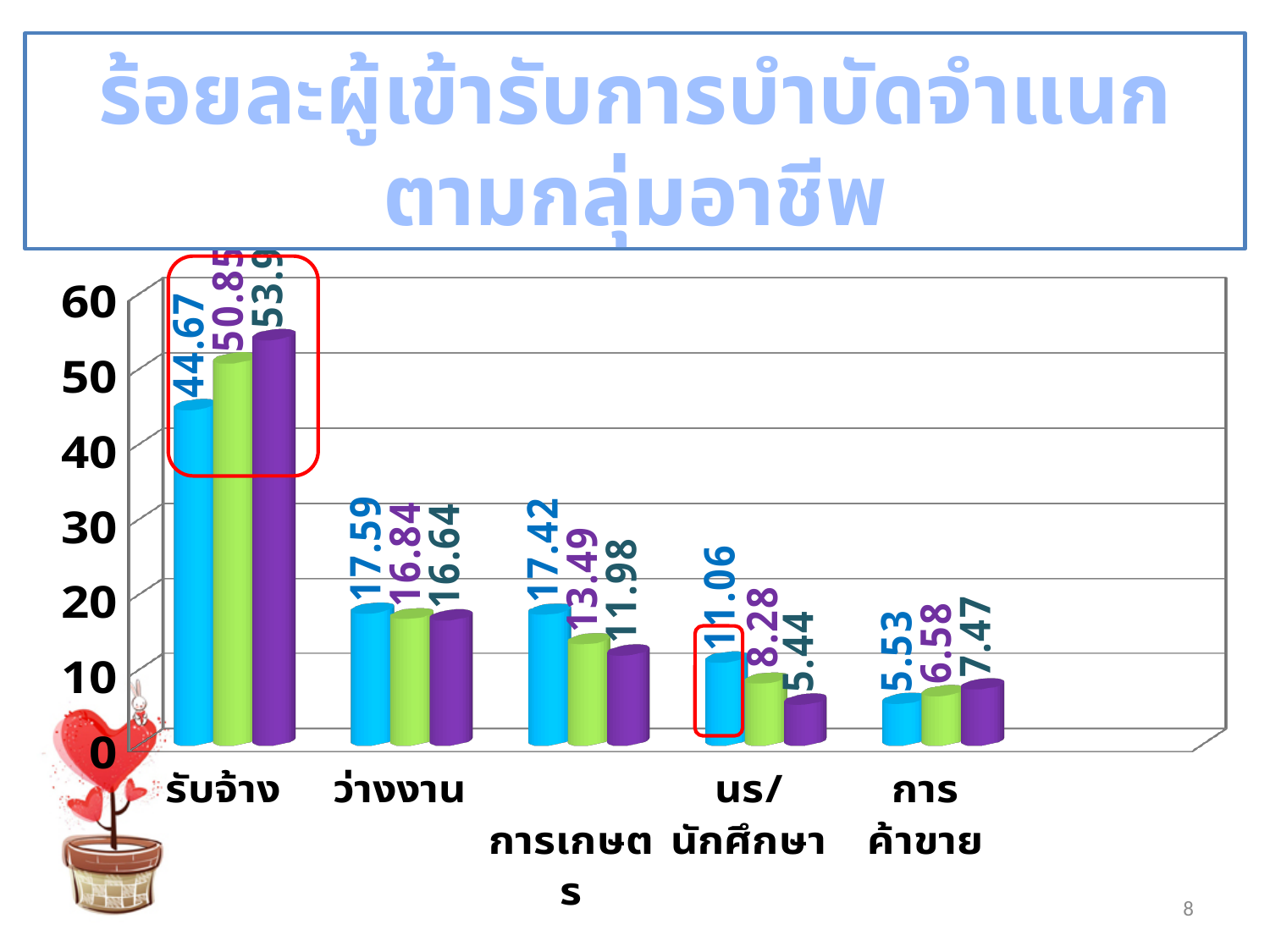
Which occupation category has the lowest blue bar? การค้าขาย What kind of chart is shown on the slide? bar chart What is the value of the purple bar for นร/นักศึกษา? 5.44 What is the value of the green bar for การเกษตร? 13.49 Which is larger: the green bar for ว่างงาน or the green bar for การเกษตร? ว่างงาน What is the value of the blue bar for ว่างงาน? 17.59 What is the difference between the blue bar for นร/นักศึกษา and the blue bar for การค้าขาย? 5.53 How many bars are plotted for each occupation category? 3 Which occupation category has the highest values across all three bars? รับจ้าง How many occupation categories are shown on the x axis? 5 Is the value of the green bar for รับจ้าง greater or less than 40? greater What is the value of the blue bar for รับจ้าง? 44.67